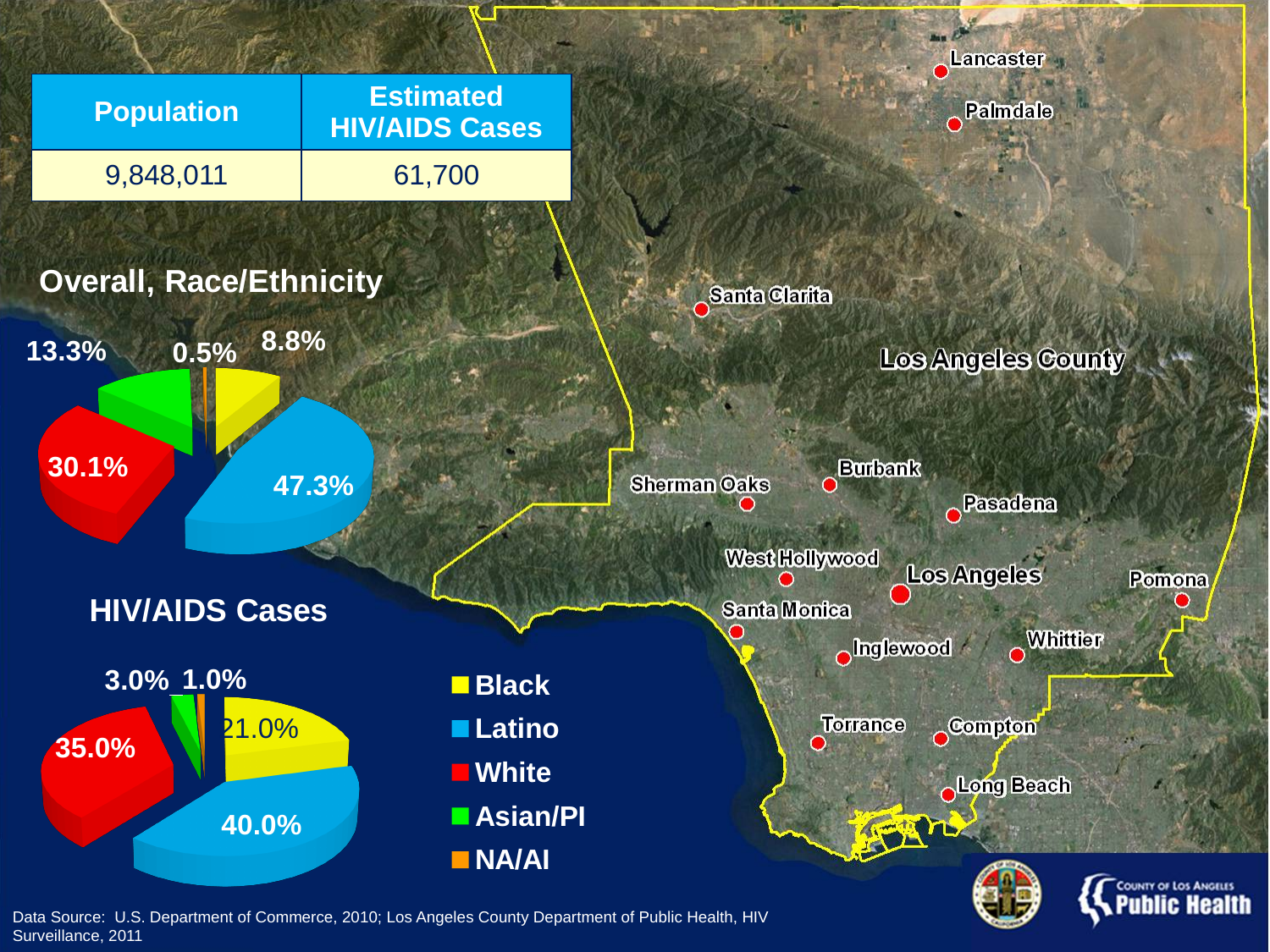
In the "Overall, Race/Ethnicity" pie chart, what share is Black? 8.8% In the "Overall, Race/Ethnicity" pie chart, which is larger, the White share or the Asian/PI share? White In the "Overall, Race/Ethnicity" pie chart, what share is Latino? 47.3% In the "HIV/AIDS Cases" pie chart, what share is White? 35.0% Which colour represents Latino in the legend? Blue In the "HIV/AIDS Cases" pie chart, what share is Asian/PI? 3.0% What type of chart is used for "Overall, Race/Ethnicity"? Pie chart In the "Overall, Race/Ethnicity" pie chart, which group has the smallest share? NA/AI How many slices does the "HIV/AIDS Cases" pie chart have? 5 In the "Overall, Race/Ethnicity" pie chart, which group has the largest share? Latino In the "HIV/AIDS Cases" pie chart, what is the difference between the Latino and White shares? 5.0% In the "HIV/AIDS Cases" pie chart, which group has the largest share? Latino